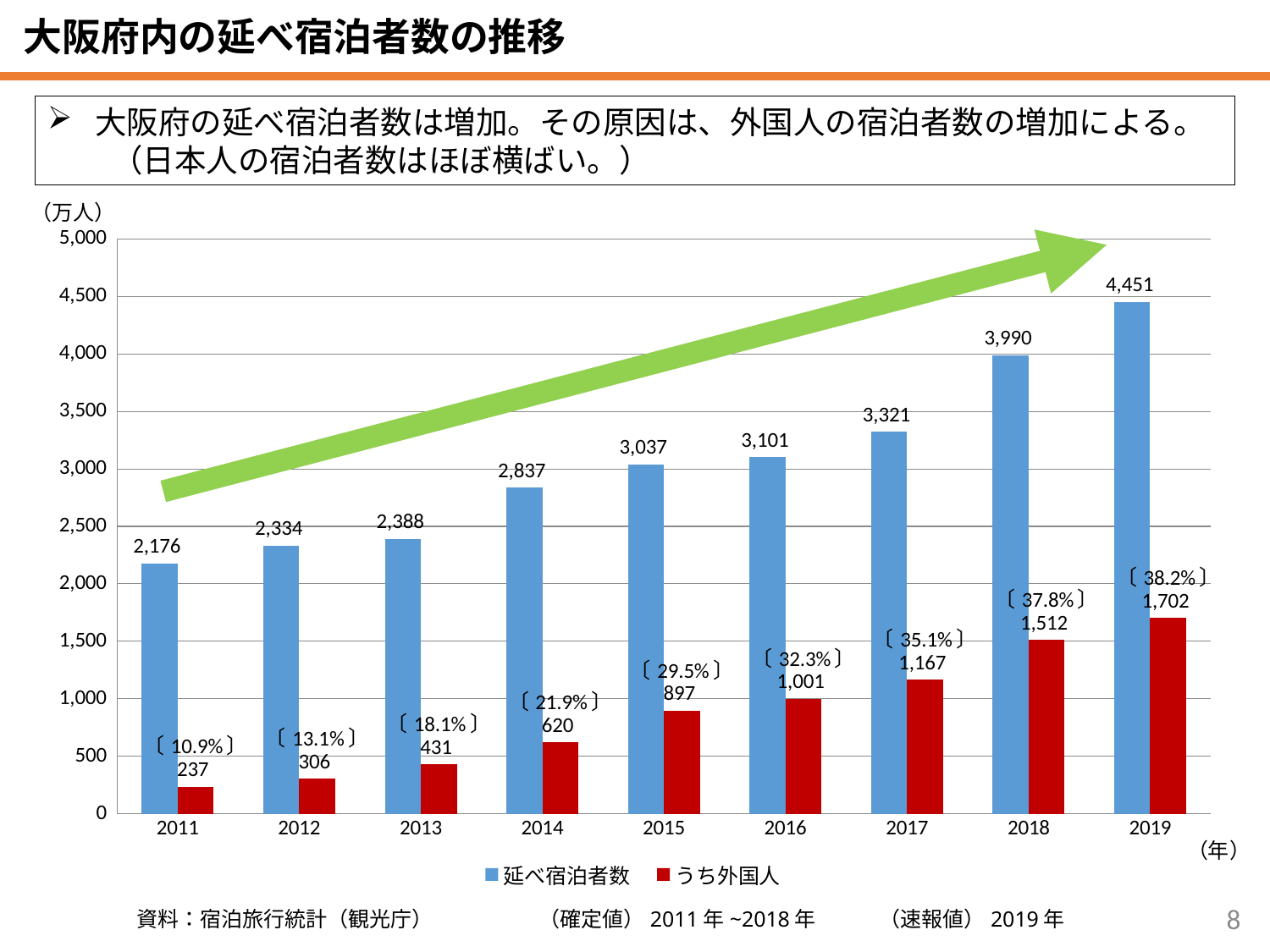
Does the うち外国人 series rise or fall from 2011 to 2019? rise Which year has the lowest うち外国人 value? 2011 How many years are shown on the x axis? 9 Which is larger: うち外国人 in 2016 or 延べ宿泊者数 in 2011? 延べ宿泊者数 in 2011 What percentage is shown in brackets above the うち外国人 bar for 2017? 35.1% Which year has the highest 延べ宿泊者数? 2019 How many series does the legend list? 2 What is the difference between 延べ宿泊者数 in 2019 and 2018? 461 Is the 延べ宿泊者数 value for 2014 greater or less than 3,000? less What is the value of 延べ宿泊者数 for 2019? 4,451 What kind of chart is shown on the slide? bar chart What is the value of うち外国人 for 2015? 897